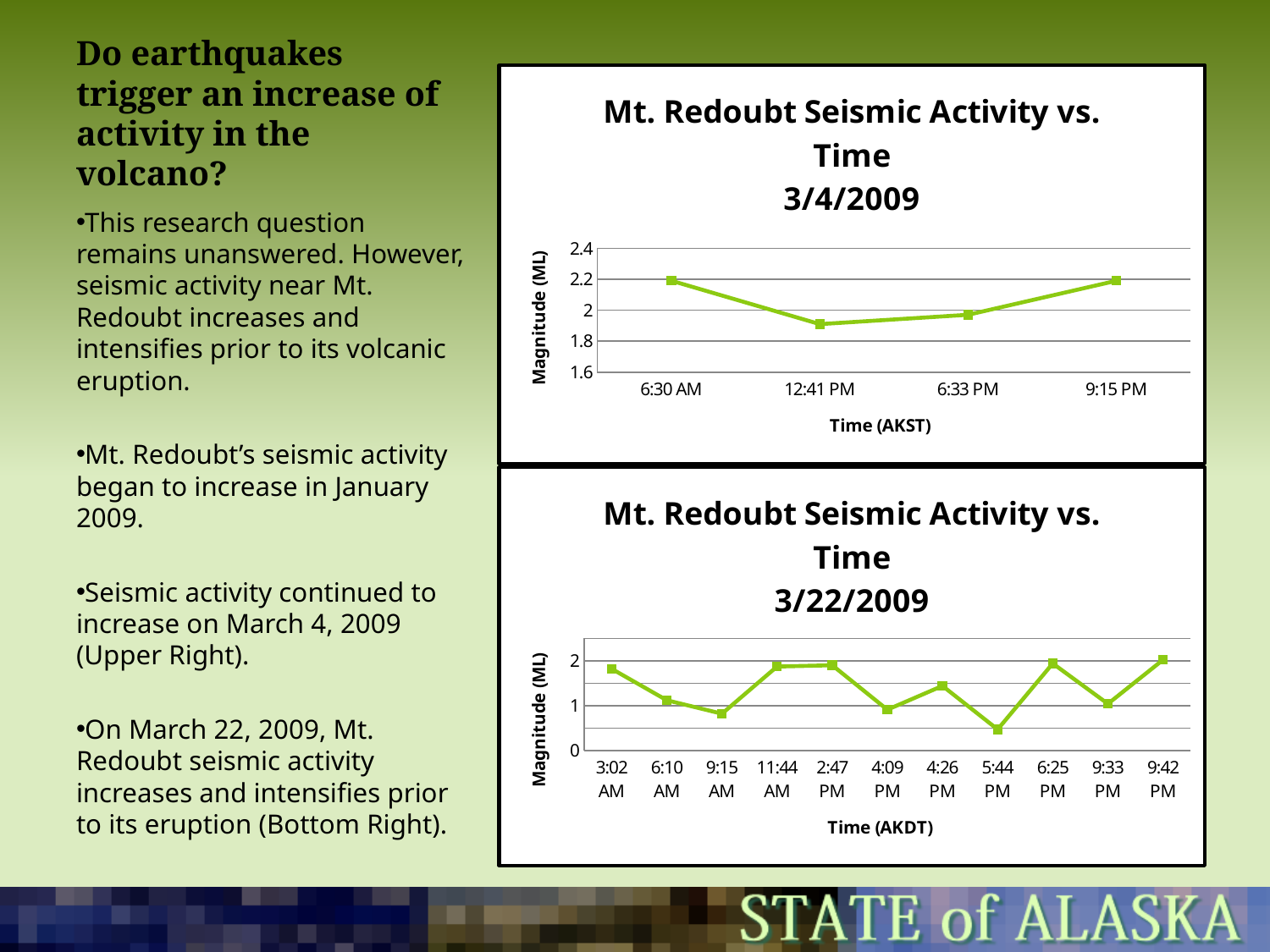
What kind of chart is the upper chart titled 'Mt. Redoubt Seismic Activity vs. Time 3/4/2009'? line chart In the lower chart (3/22/2009), is the magnitude at 5:44 PM greater or less than 1? less What is the x-axis label on the upper chart (3/4/2009)? Time (AKST) In the lower chart (3/22/2009), which has the larger magnitude, 11:44 AM or 9:15 AM? 11:44 AM How many time points are plotted in the upper chart (3/4/2009)? 4 In the upper chart (3/4/2009), is the magnitude at 12:41 PM greater or less than 2? less In the upper chart (3/4/2009), which time has the lowest magnitude? 12:41 PM In the upper chart (3/4/2009), does the magnitude rise or fall from 12:41 PM to 9:15 PM? rise In the upper chart (3/4/2009), is the magnitude at 6:30 AM greater or less than 2? greater In the lower chart (3/22/2009), which time has the lowest magnitude? 5:44 PM How many time points are plotted in the lower chart (3/22/2009)? 11 What is the y-axis label on the lower chart (3/22/2009)? Magnitude (ML)